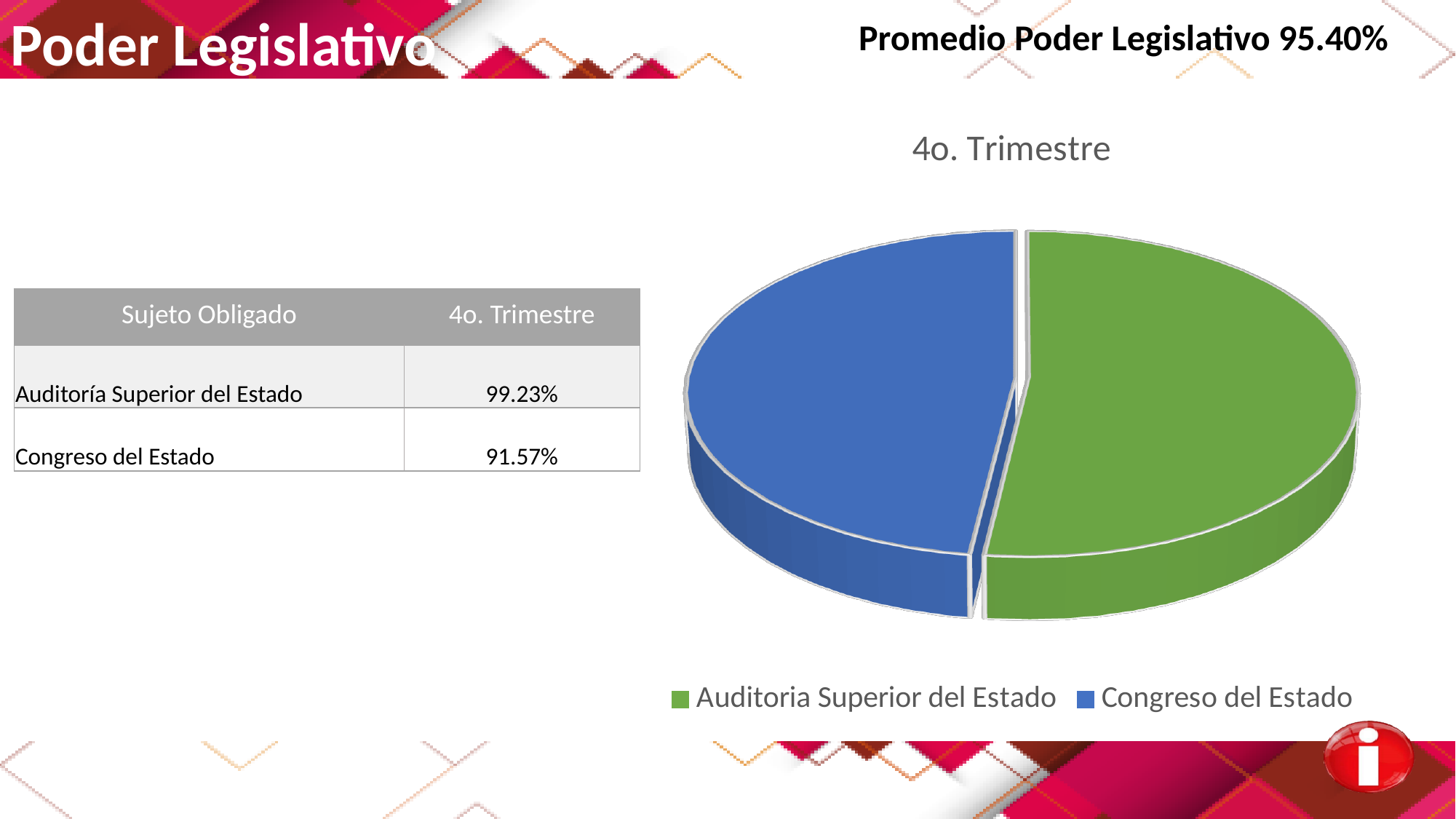
What is the title of the pie chart? 4o. Trimestre What is the 4o. Trimestre value for Auditoría Superior del Estado? 99.23% How many entries does the legend of the pie chart list? 2 Which category has the lowest 4o. Trimestre value? Congreso del Estado Which category has the higher 4o. Trimestre value, Auditoría Superior del Estado or Congreso del Estado? Auditoría Superior del Estado What is the 4o. Trimestre value for Congreso del Estado? 91.57% What is the Promedio Poder Legislativo shown on the slide? 95.40% What is the difference between the 4o. Trimestre values of Auditoría Superior del Estado and Congreso del Estado? 7.66% How many slices does the pie chart have? 2 What kind of chart is shown on the slide? pie chart Which colour represents Congreso del Estado in the pie chart? blue